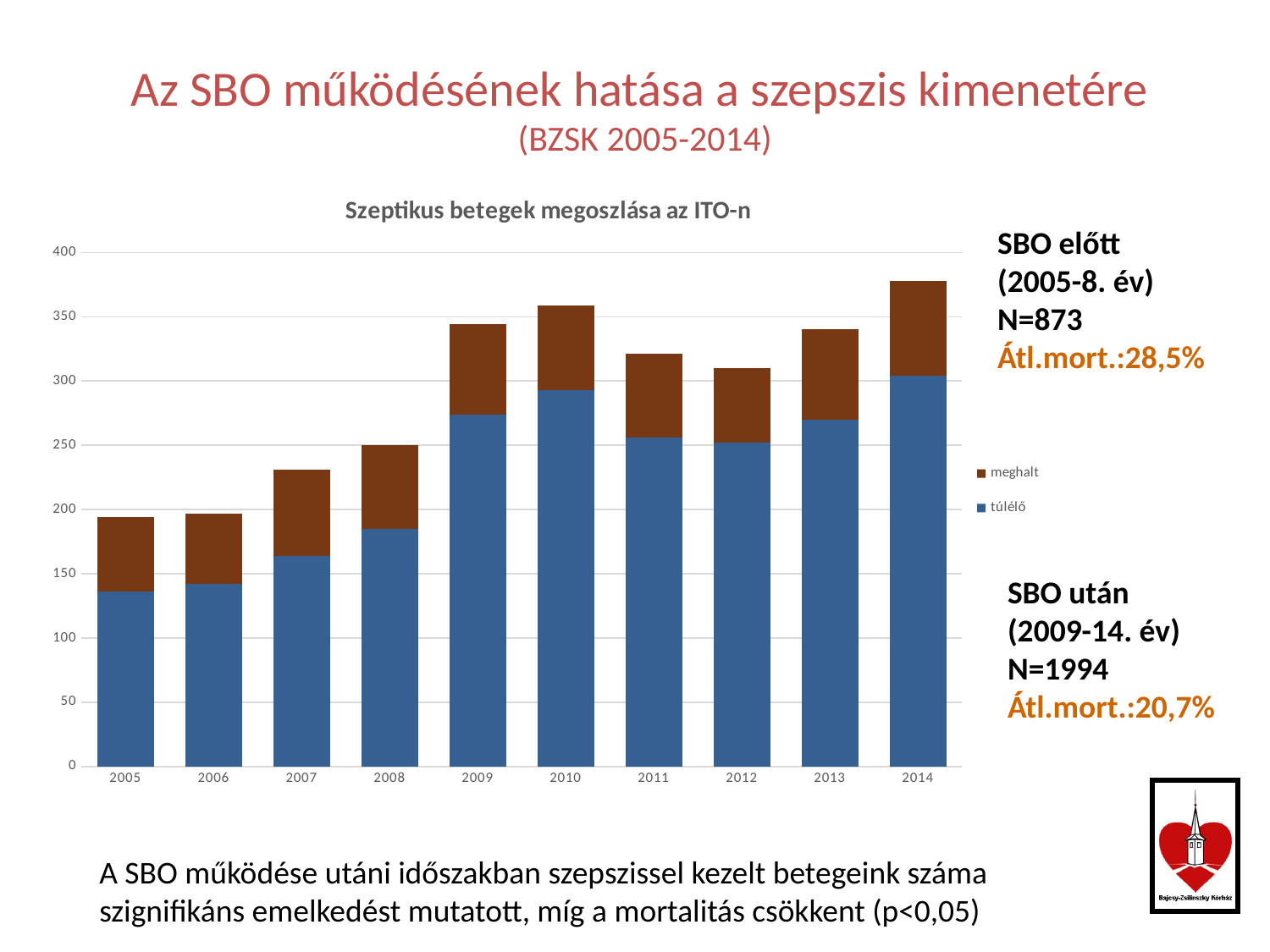
How many series does the chart's legend list? 2 Is the total height of the bar for 2008 greater or less than 300? less What is the title of the chart? Szeptikus betegek megoszlása az ITO-n Is the túlélő value for 2005 greater or less than 150? less Is the total height of the bar for 2014 greater or less than 350? greater What kind of chart is shown on the slide? stacked bar chart How many years are shown on the x axis of the chart? 10 Which year has the taller stacked bar, 2008 or 2009? 2009 Do the total bar heights generally rise or fall from 2005 to 2010? rise Which year has the tallest stacked bar in the chart? 2014